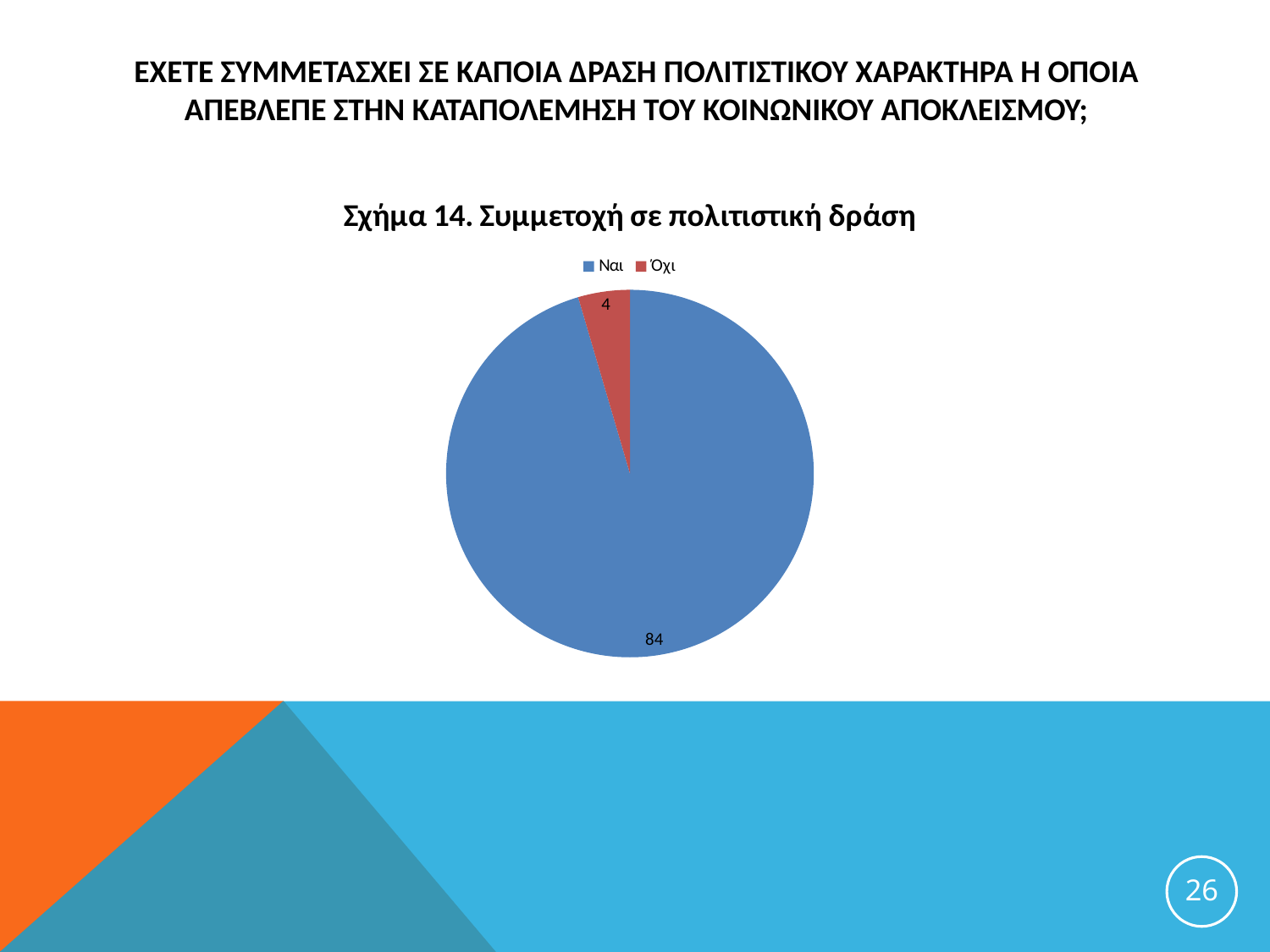
Which category has the smallest slice? Όχι What is the value for Ναι? 84 What is the value for Όχι? 4 How many slices does the pie chart have? 2 What is the difference between the values for Ναι and Όχι? 80 How many entries does the legend list? 2 What kind of chart is shown on the slide? pie chart Which is larger, the value for Ναι or the value for Όχι? Ναι What is the total of all slices in the pie chart? 88 What is the chart's title? Σχήμα 14. Συμμετοχή σε πολιτιστική δράση What colour is the slice for Όχι? red Which category has the largest slice? Ναι